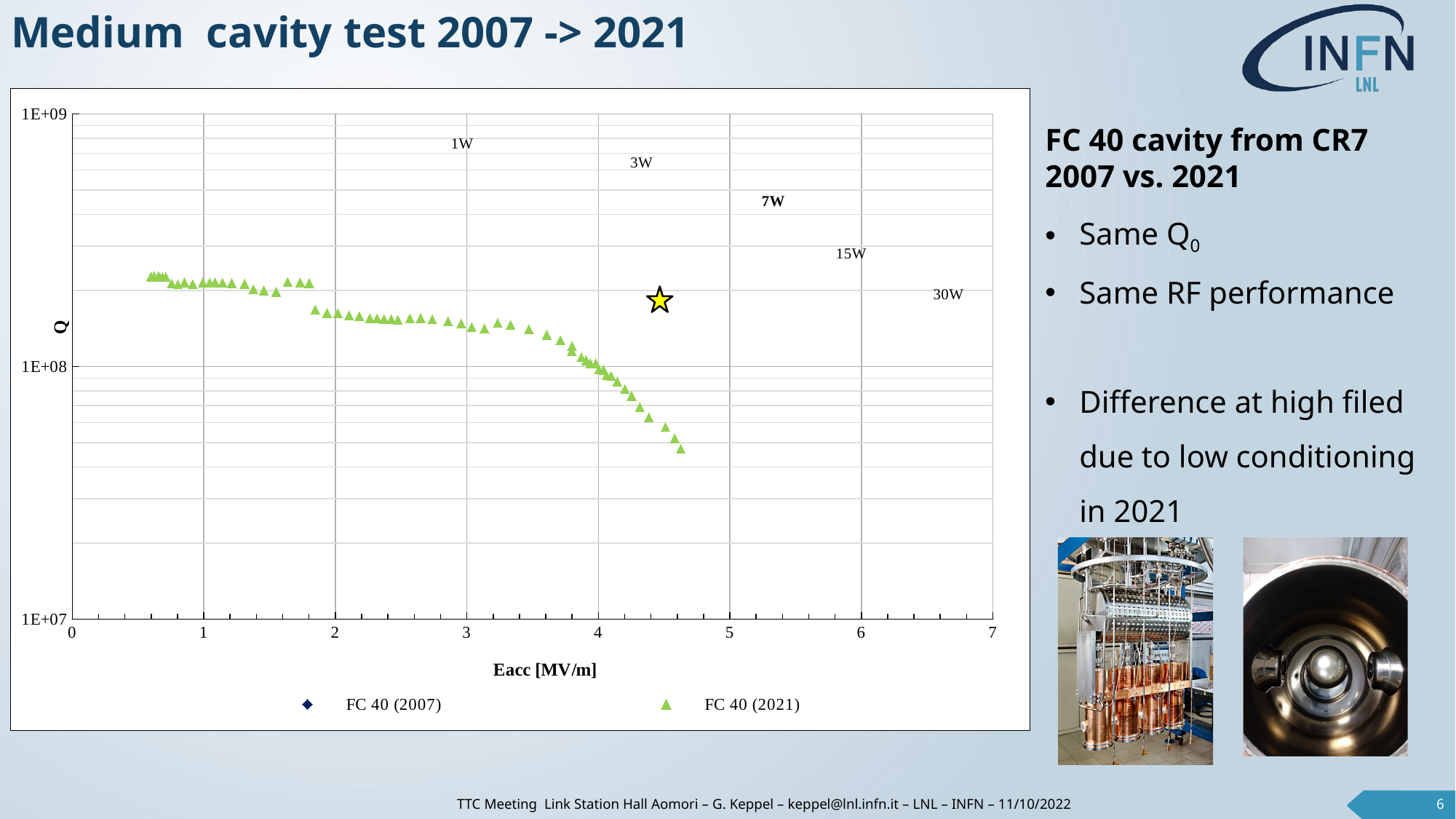
What is the label of the x axis of the chart? Eacc [MV/m] How many series does the chart legend list? 2 As Eacc increases along the x axis, does the Q value of the FC 40 (2021) series rise or fall overall? Fall Is the Q value of the FC 40 (2021) series at its highest Eacc (around 4.6 MV/m) greater or less than 1E+08? less What are the two series named in the chart legend? FC 40 (2007) and FC 40 (2021) What kind of chart is shown on the slide? Scatter chart Is the Q value of the FC 40 (2021) series at Eacc = 1 MV/m greater or less than 1E+08? greater What is the maximum value shown on the x axis of the chart? 7 Is the Q value of the FC 40 (2021) series at Eacc = 3 MV/m greater or less than 1E+08? greater How many power-level labels (such as 1W, 3W) are printed on the chart? 5